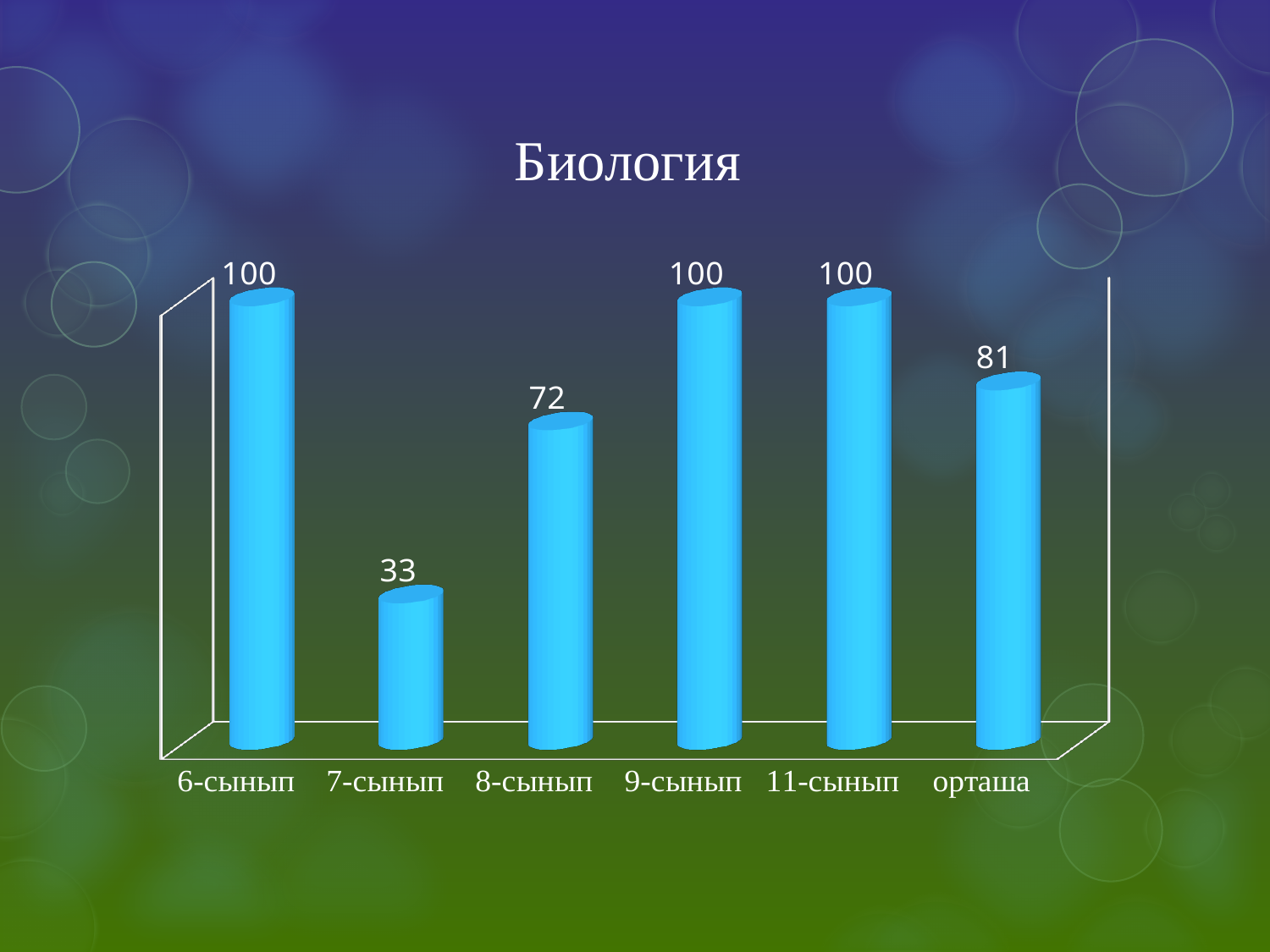
What is the value for орташа? 81 What is the value for 7-сынып? 33 Which is larger, the value for 8-сынып or the value for орташа? орташа What is the value for 8-сынып? 72 What is the difference between the values for 8-сынып and 7-сынып? 39 What kind of chart is shown on the slide? bar chart What is the title of the chart? Биология Which is larger, the value for 7-сынып or the value for 8-сынып? 8-сынып Which category has the lowest value? 7-сынып What is the value for 6-сынып? 100 What is the difference between the values for 9-сынып and орташа? 19 How many categories are shown on the x axis? 6